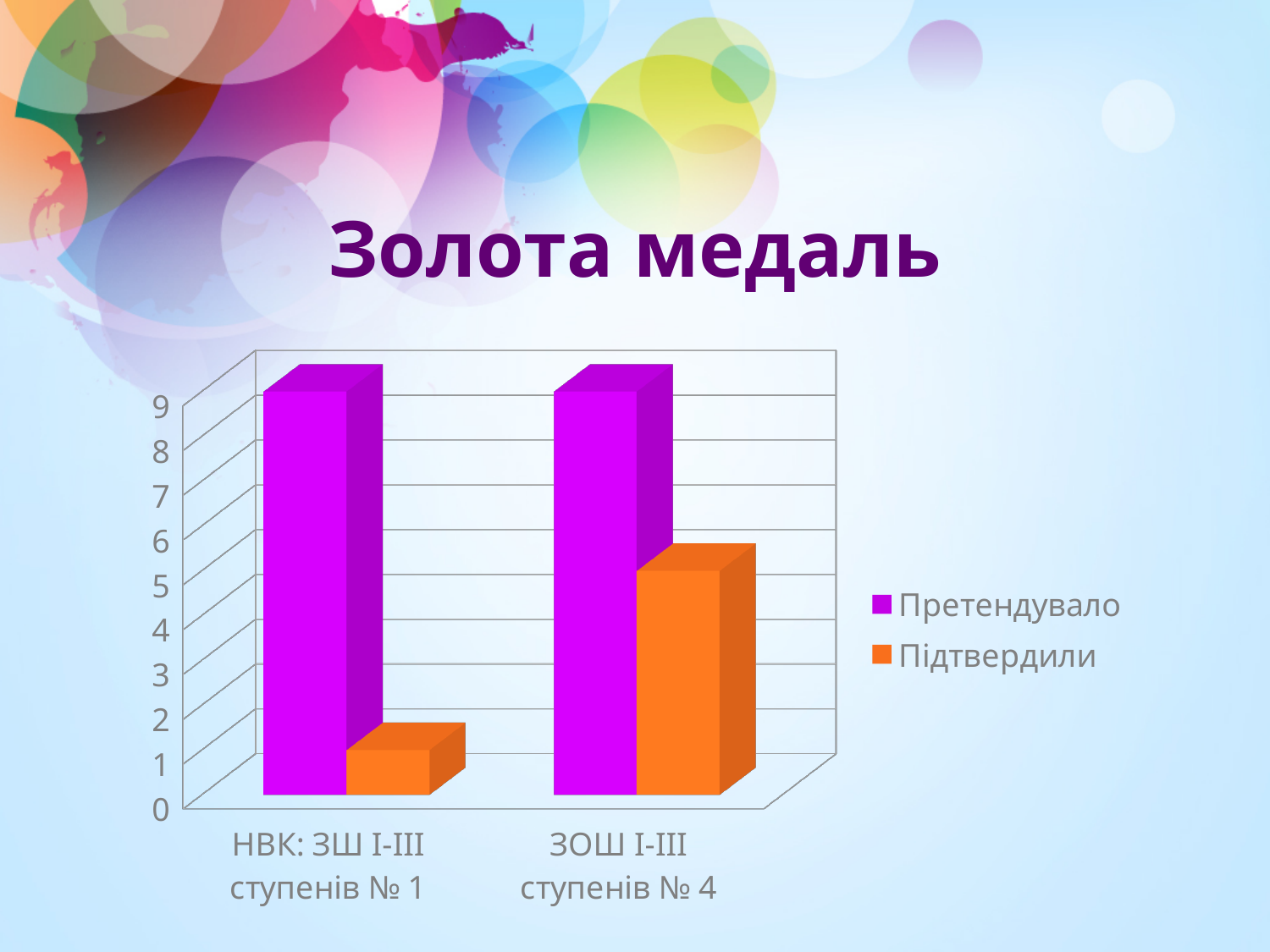
Which category has the higher value for Підтвердили? ЗОШ І-ІІІ ступенів № 4 Is the value of Підтвердили for НВК: ЗШ І-ІІІ ступенів № 1 greater or less than 2? less What is the title of the chart? Золота медаль How many series does the legend list? 2 Is the value of Підтвердили for ЗОШ І-ІІІ ступенів № 4 greater or less than 6? less Which category has the lower value for Підтвердили? НВК: ЗШ І-ІІІ ступенів № 1 Which series is shown in orange? Підтвердили What kind of chart is shown on the slide? bar chart For ЗОШ І-ІІІ ступенів № 4, which is larger: Претендувало or Підтвердили? Претендувало Is the value of Підтвердили for ЗОШ І-ІІІ ступенів № 4 greater or less than 4? greater How many categories are shown on the x axis? 2